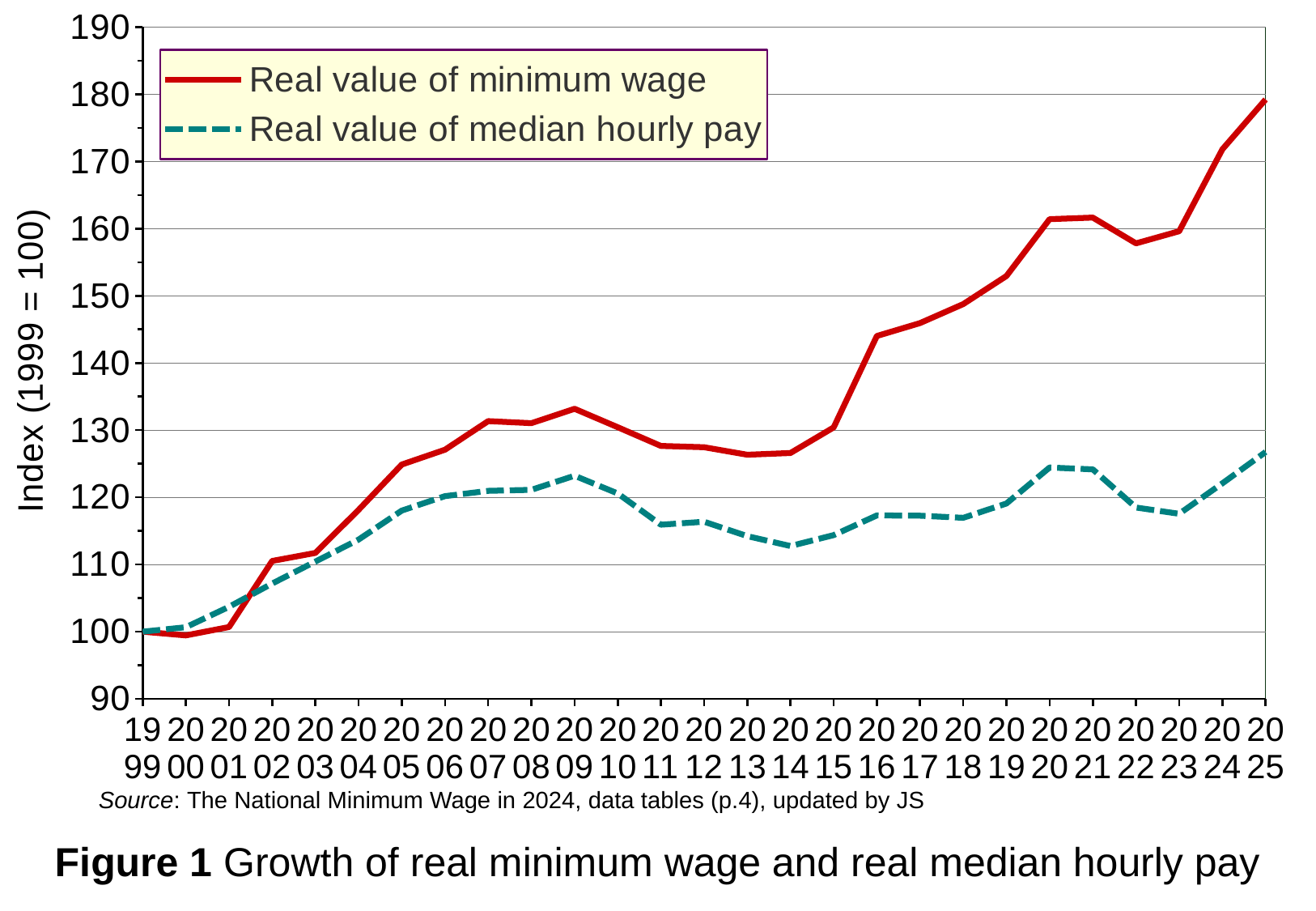
Overall, does the real value of minimum wage rise or fall from 1999 to 2025? rise How many years are plotted along the x axis? 27 What kind of chart is shown on the slide? line chart What is the value of the real value of minimum wage index in 1999? 100 What is the label on the vertical axis? Index (1999 = 100) How many series does the legend list? 2 Is the value for real value of median hourly pay in 2014 greater or less than 120? less Is the value for real value of minimum wage in 2022 greater or less than 160? less Is the value for real value of minimum wage in 2025 greater or less than 170? greater In 2025, which series has the larger value: real value of minimum wage or real value of median hourly pay? Real value of minimum wage In which year is the real value of minimum wage at its highest? 2025 In which year is the real value of median hourly pay at its lowest? 1999